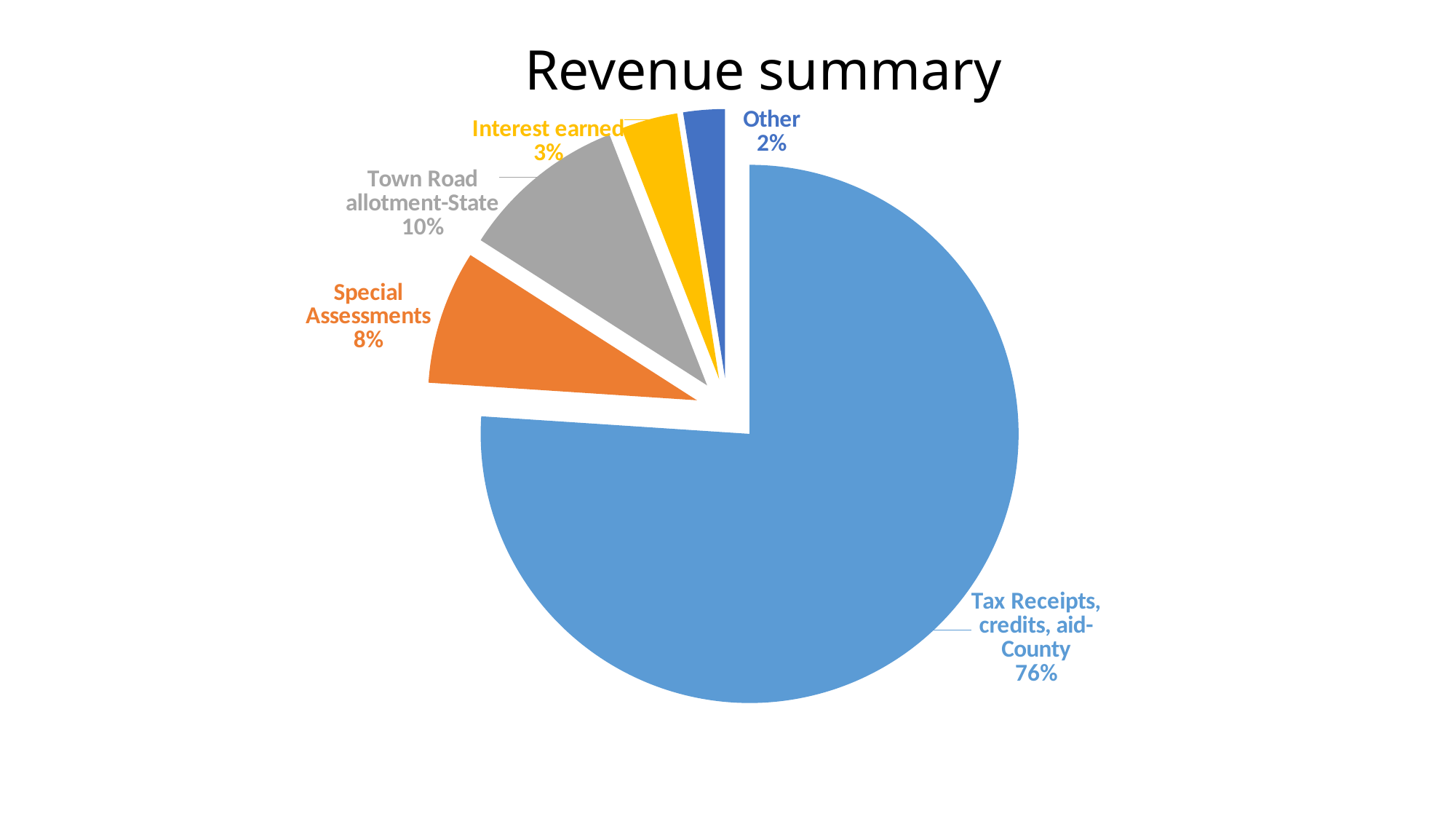
Which is larger, the share for Interest earned or the share for Other? Interest earned What is the difference in percentage points between Town Road allotment-State and Special Assessments? 2 Which category has the smallest share of the pie? Other What is the title of the chart? Revenue summary What share of revenue comes from Other? 2% What share of revenue comes from Tax Receipts, credits, aid-County? 76% What share of revenue comes from Special Assessments? 8% How many slices does the pie chart have? 5 What kind of chart is shown on the slide? pie chart Which category has the largest share of the pie? Tax Receipts, credits, aid-County